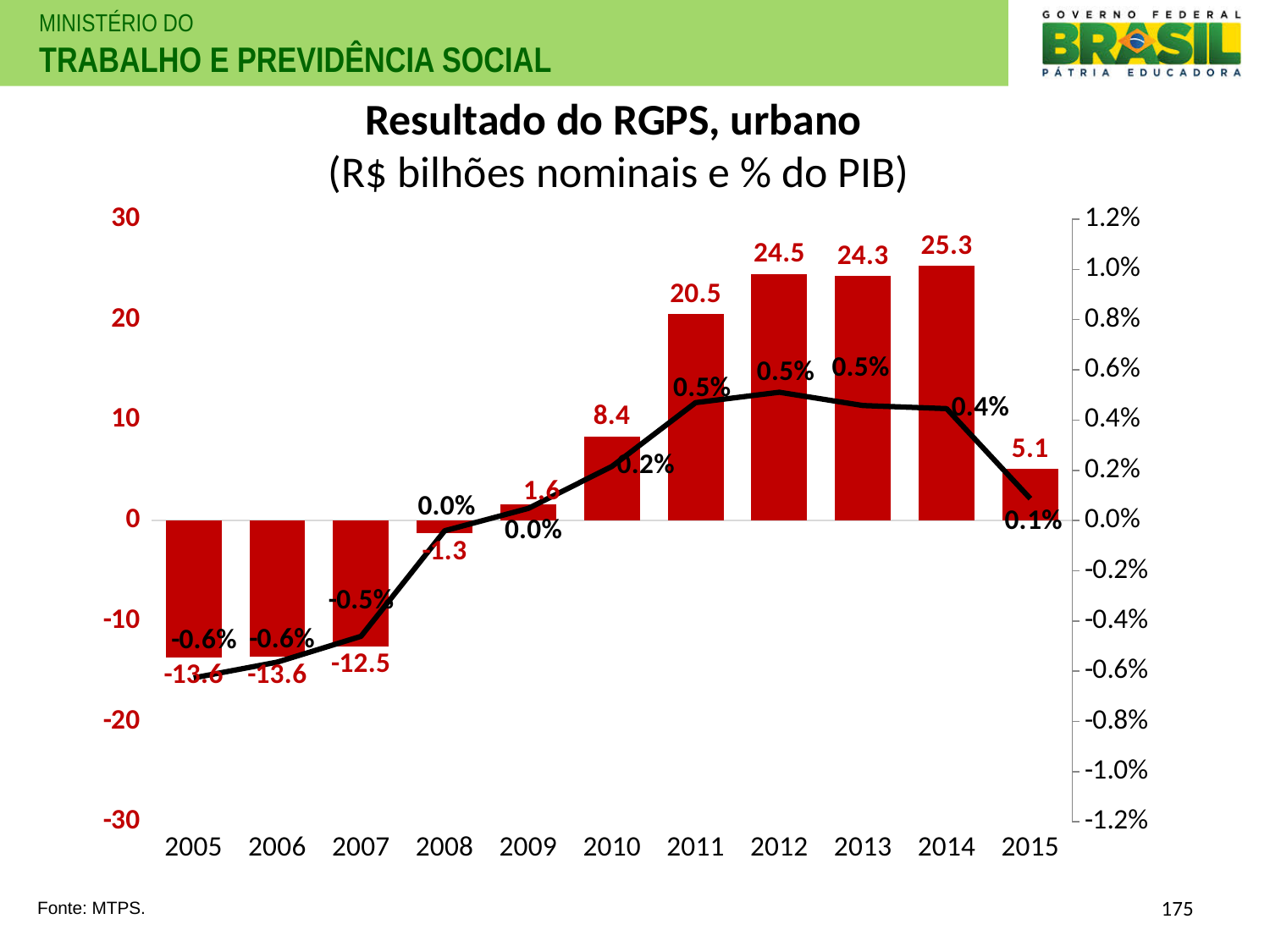
Which year has the lowest bar value? 2005 and 2006 (both -13.6) What is the % of PIB value shown on the line for 2015? 0.1% What is the % of PIB value shown on the line for 2012? 0.5% Which year has the larger bar value, 2011 or 2012? 2012 Which year has the highest bar value? 2014 Do the bar values rise or fall from 2005 to 2014? Rise What is the bar value (R$ billions) for 2010? 8.4 What is the bar value (R$ billions) for 2014? 25.3 What kind of chart is this? Combined bar and line chart What is the difference between the bar values for 2014 and 2015? 20.2 What is the title of the chart? Resultado do RGPS, urbano (R$ bilhões nominais e % do PIB) How many years are shown on the x axis? 11